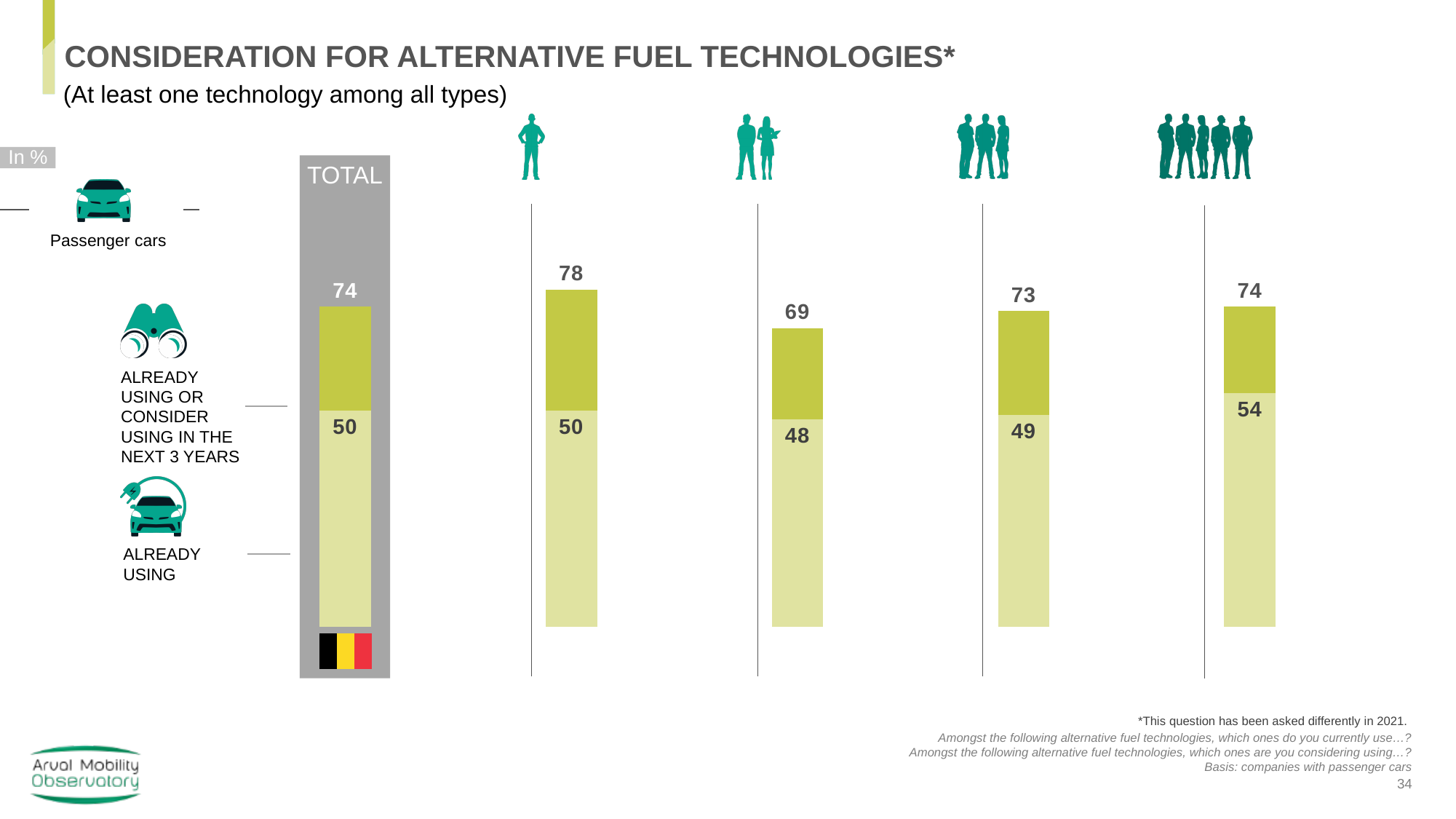
What kind of chart is shown on the slide? Bar chart How many series does the chart show? 2 Is the 'already using' value larger for the fourth company-size group or for the TOTAL? The fourth company-size group (54) What is the 'already using or consider using in the next 3 years' value for the first company-size group (single-person icon)? 78 How many bars (TOTAL plus company-size groups) are shown in the chart? 5 What is the TOTAL value for 'already using' for passenger cars? 50 What is the difference between the 'already using or consider using' value and the 'already using' value for the third company-size group (three-person icon)? 24 What is the 'already using' value for the fourth company-size group (largest group icon)? 54 Which company-size group has the highest 'already using or consider using in the next 3 years' value? The first group (single-person icon), 78 Which company-size group has the lowest 'already using' value? The second group (two-person icon), 48 What is the TOTAL value for 'already using or consider using in the next 3 years' for passenger cars? 74 What is the 'already using' value for the second company-size group (two-person icon)? 48